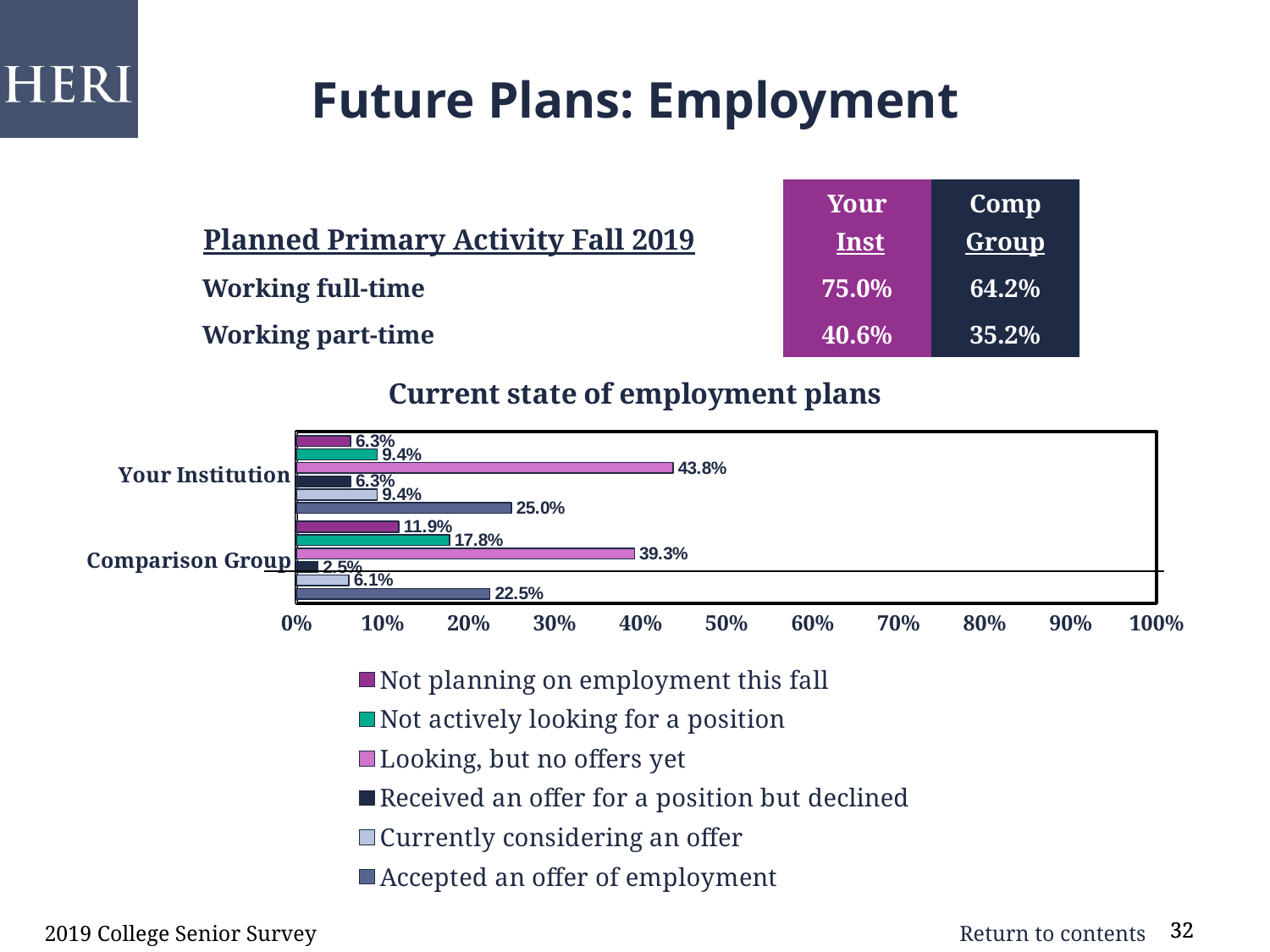
In the 'Current state of employment plans' chart, is the value for 'Accepted an offer of employment' for Your Institution greater or less than 20%? greater In the 'Current state of employment plans' chart, what is the value for 'Accepted an offer of employment' for the Comparison Group? 22.5% What kind of chart is 'Current state of employment plans'? bar chart In the 'Current state of employment plans' chart, which series has the lowest value for the Comparison Group? Received an offer for a position but declined How many series does the legend of the 'Current state of employment plans' chart list? 6 In the 'Current state of employment plans' chart, which is larger: 'Not planning on employment this fall' for Your Institution or for the Comparison Group? Comparison Group In the 'Current state of employment plans' chart, what colour is the bar for 'Looking, but no offers yet'? pink In the 'Current state of employment plans' chart, which series has the highest value for Your Institution? Looking, but no offers yet In the 'Current state of employment plans' chart, what is the difference between 'Looking, but no offers yet' for Your Institution and for the Comparison Group? 4.5% In the 'Current state of employment plans' chart, what is the value for 'Looking, but no offers yet' for Your Institution? 43.8% How many categories are shown on the 'Current state of employment plans' chart? 2 In the 'Current state of employment plans' chart, what is the value for 'Not actively looking for a position' for the Comparison Group? 17.8%